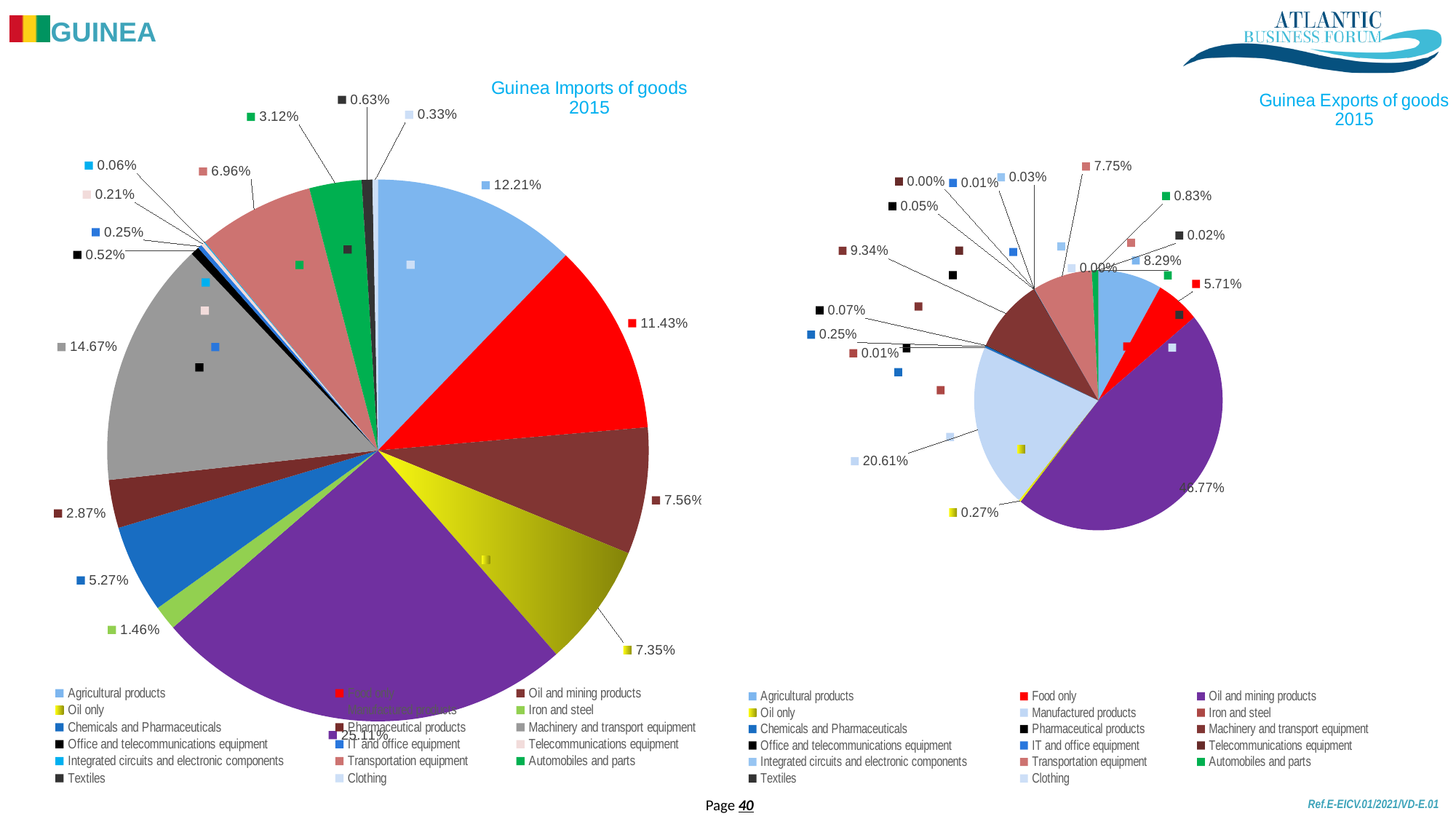
In the Guinea Imports of goods 2015 chart, what share does Machinery and transport equipment have? 14.67% In the Guinea Exports of goods 2015 chart, which category has the largest share? Oil and mining products In the Guinea Exports of goods 2015 chart, which is larger: Agricultural products or Food only? Agricultural products In the Guinea Imports of goods 2015 chart, what share do Manufactured products have? 25.11% What is the title of the chart on the left side of the slide? Guinea Imports of goods 2015 In the Guinea Imports of goods 2015 chart, which is larger: Food only or Oil and mining products? Food only In the Guinea Exports of goods 2015 chart, what share do Manufactured products have? 20.61% What type of charts are shown on the slide? Pie charts In the Guinea Imports of goods 2015 chart, what share do Agricultural products have? 12.21% In the Guinea Imports of goods 2015 chart, what is the difference between the shares of Agricultural products and Food only? 0.78% In the Guinea Imports of goods 2015 chart, which category has the largest share? Manufactured products In the Guinea Exports of goods 2015 chart, what share do Oil and mining products have? 46.77%